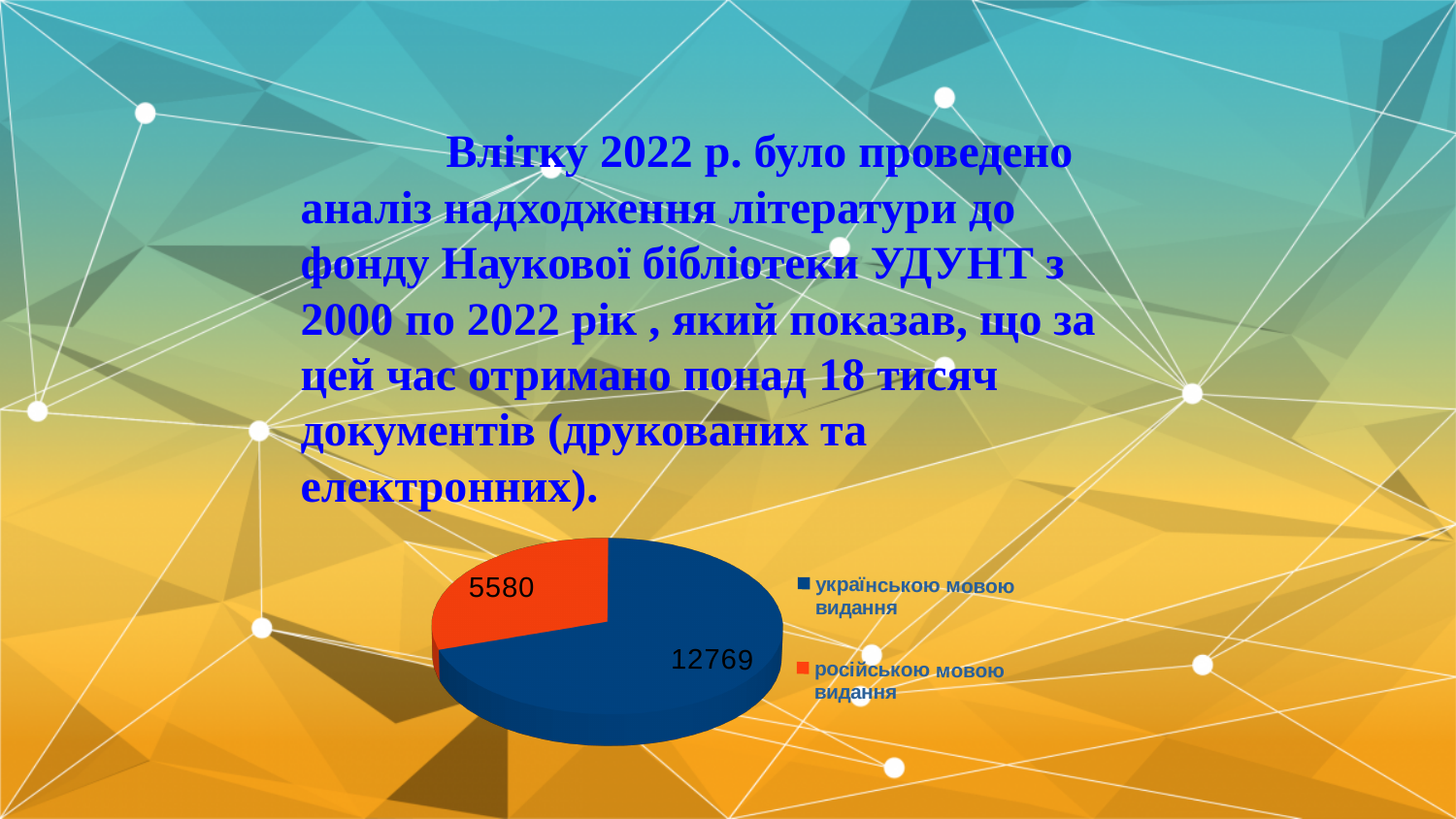
Which category has the largest slice in the pie chart? українською мовою видання How many entries does the legend of the pie chart list? 2 What is the value for "українською мовою видання" in the pie chart? 12769 Which category has the smallest slice in the pie chart? російською мовою видання What kind of chart is shown on the slide? pie chart What colour is the slice for "російською мовою видання" in the pie chart? orange-red Which is larger: the value for "українською мовою видання" or for "російською мовою видання"? українською мовою видання How many slices does the pie chart have? 2 What is the difference between the values for "українською мовою видання" and "російською мовою видання"? 7189 What is the value for "російською мовою видання" in the pie chart? 5580 What is the total of the two values shown in the pie chart? 18349